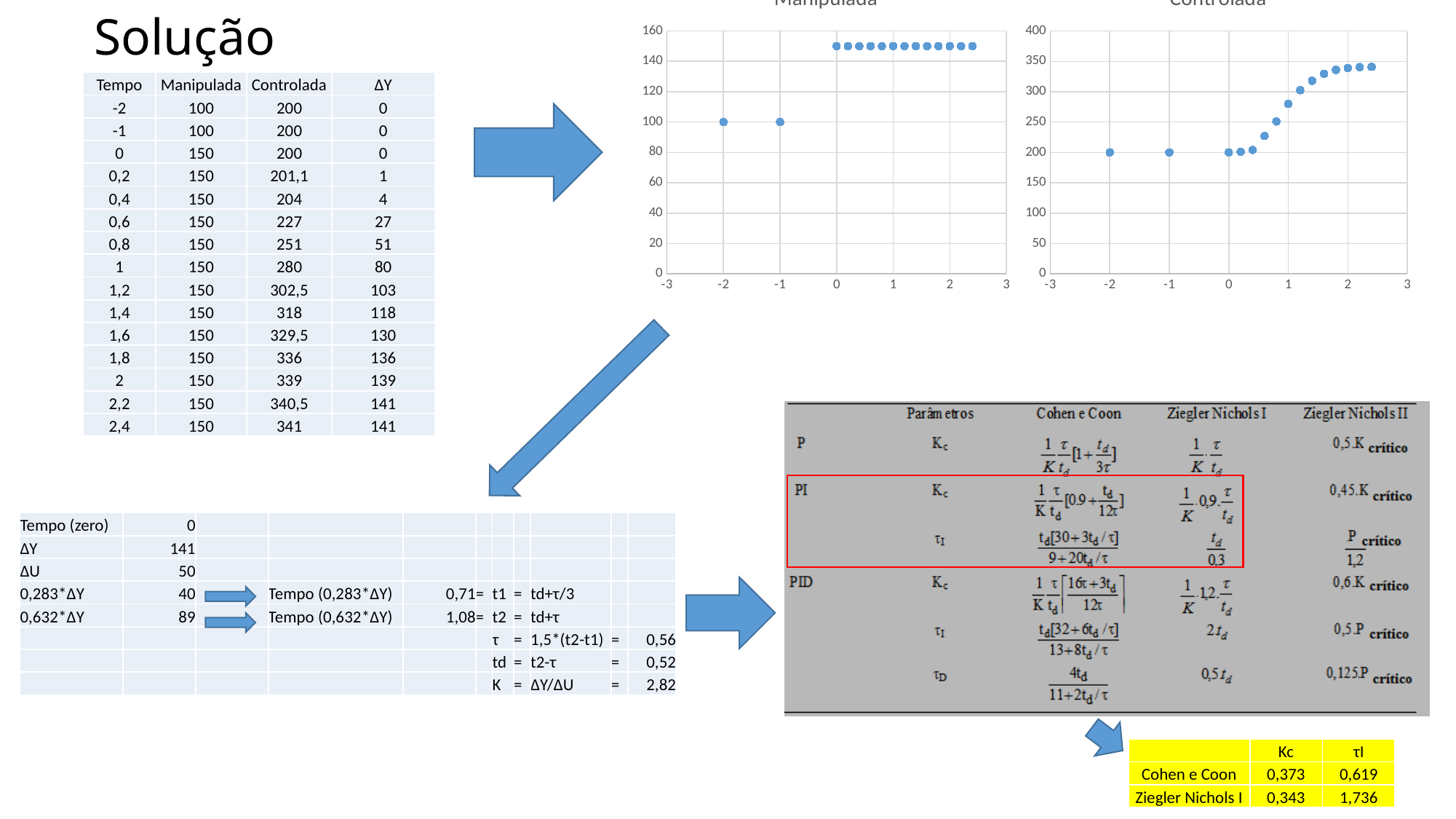
In the Controlada chart, which is larger: the value at x = 0 or the value at x = 2? x = 2 In the Manipulada chart, what is the value at x = -2? 100 What kind of chart is the Manipulada chart? scatter chart In the Controlada chart, is the value at x = 0.4 greater or less than 250? less In the Controlada chart, what is the value at x = -1? 200 In the Manipulada chart, is the value at x = 1 greater or less than 140? greater In the Manipulada chart, how many data points are plotted? 15 What is the highest value shown on the y axis of the Controlada chart? 400 What range does the x axis of the Manipulada chart cover? -3 to 3 In the Controlada chart, do the values rise or fall as x increases from 0 to 2? rise In the Controlada chart, is the value at x = 2 greater or less than 300? greater In the Manipulada chart, which is larger: the value at x = -1 or the value at x = 1? x = 1